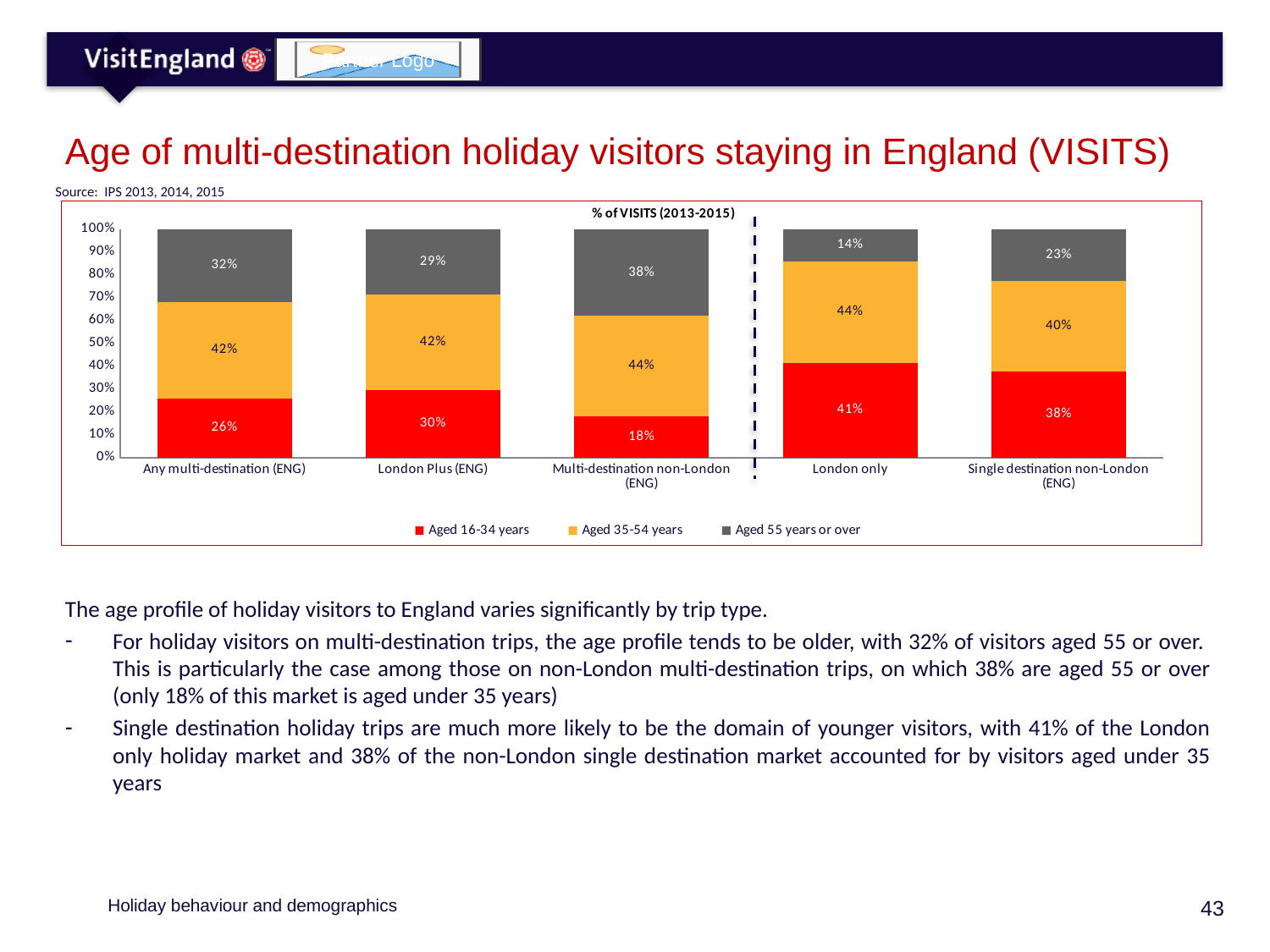
What percentage of London only holiday visits are by visitors aged 16-34 years? 41% What is the value for Aged 35-54 years in the London Plus (ENG) category? 42% Which is larger: the Aged 16-34 years share for Any multi-destination (ENG) or for Single destination non-London (ENG)? Single destination non-London (ENG) How many series does the legend list? 3 Which colour represents the Aged 35-54 years series in the chart? Orange What is the difference between the Aged 55 years or over share for Multi-destination non-London (ENG) and London only? 24 percentage points What is the title shown above the chart? % of VISITS (2013-2015) Which category has the lowest share of visitors aged 55 years or over? London only Which category has the highest share of visitors aged 16-34 years? London only How many trip-type categories are shown on the x axis? 5 What type of chart is shown on the slide? Stacked bar chart What share of Multi-destination non-London (ENG) visits are by visitors aged 55 years or over? 38%